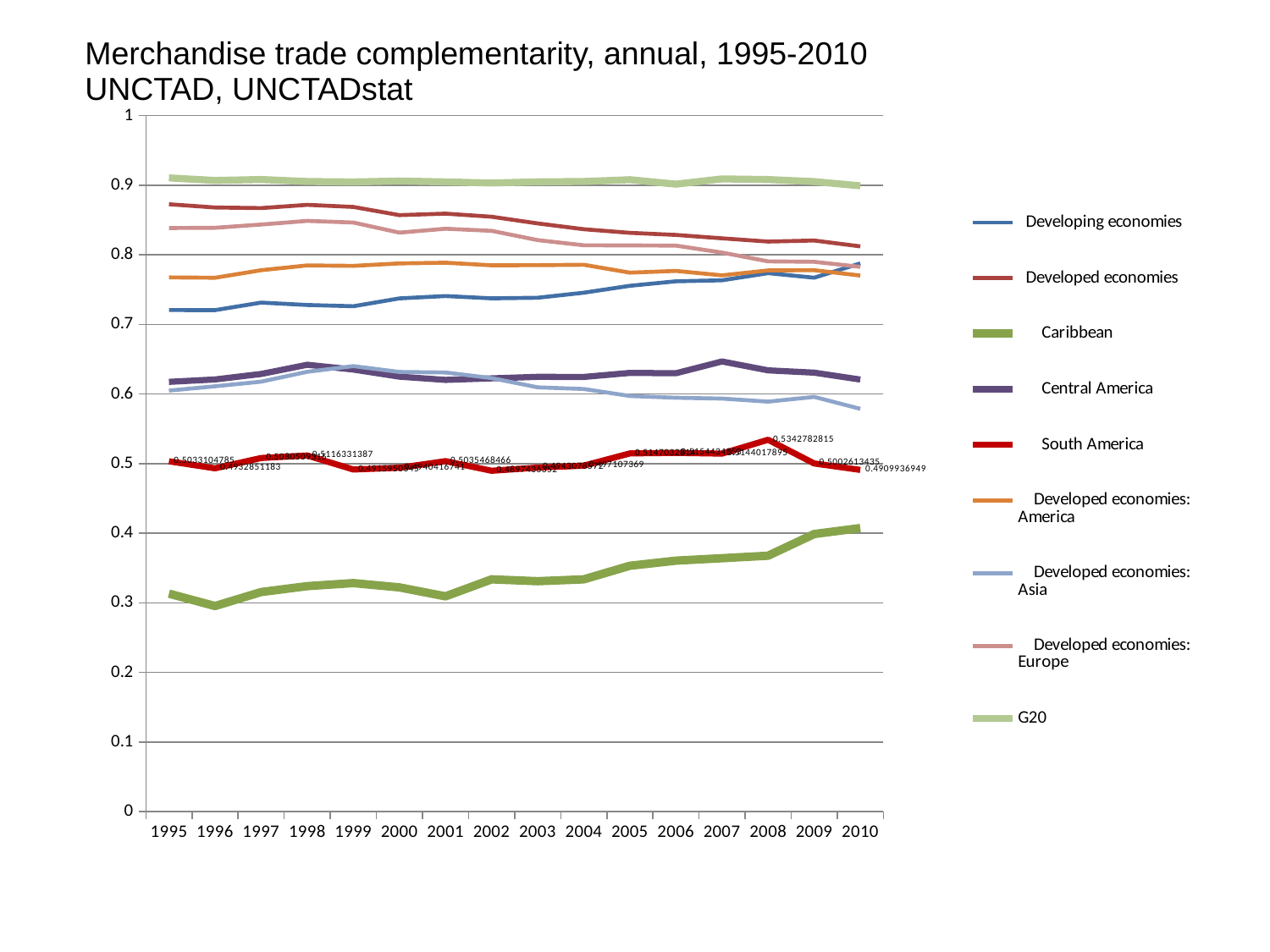
What kind of chart is shown on the slide? line chart What is the value for South America in 1995? 0.5033104785 How many years are plotted along the x axis? 16 How many series does the legend list? 9 In 2010, which is higher: Developed economies or Developing economies? Developed economies Is the value for Caribbean in 1995 greater or less than 0.4? less What is the value for South America in 2010? 0.4909936949 Is the value for Developed economies: Asia in 2010 greater or less than 0.6? less What is the value for South America in 2008? 0.5342782815 Does the Caribbean series generally rise or fall from 1995 to 2010? rise Which series has the highest values across the whole period? G20 Which series has the lowest values across the whole period? Caribbean